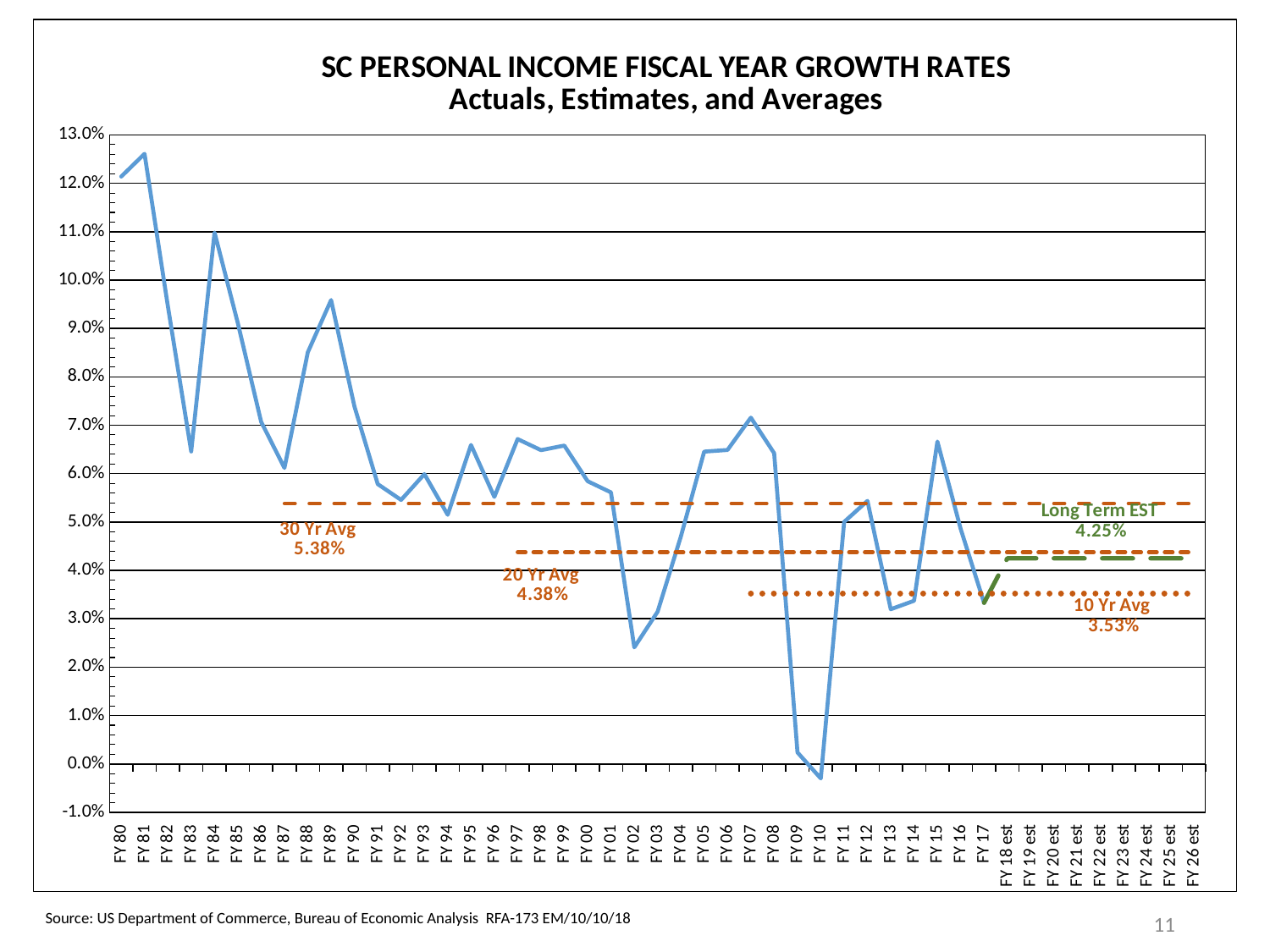
What is the 20 Yr Avg growth rate shown on the chart? 4.38% Which fiscal year has the highest growth rate on the chart? FY 81 Which fiscal year has the lowest growth rate on the chart? FY 10 What kind of chart is shown on the slide? line chart What is the 30 Yr Avg growth rate shown on the chart? 5.38% Which is larger, the 20 Yr Avg or the Long Term EST? 20 Yr Avg What is the difference between the 30 Yr Avg and the 10 Yr Avg? 1.85% Is the growth rate for FY 10 greater or less than 0.0%? less What is the title of the chart? SC PERSONAL INCOME FISCAL YEAR GROWTH RATES Actuals, Estimates, and Averages Is the growth rate for FY 84 greater or less than 10.0%? greater What is the Long Term EST growth rate shown on the chart? 4.25% What is the 10 Yr Avg growth rate shown on the chart? 3.53%